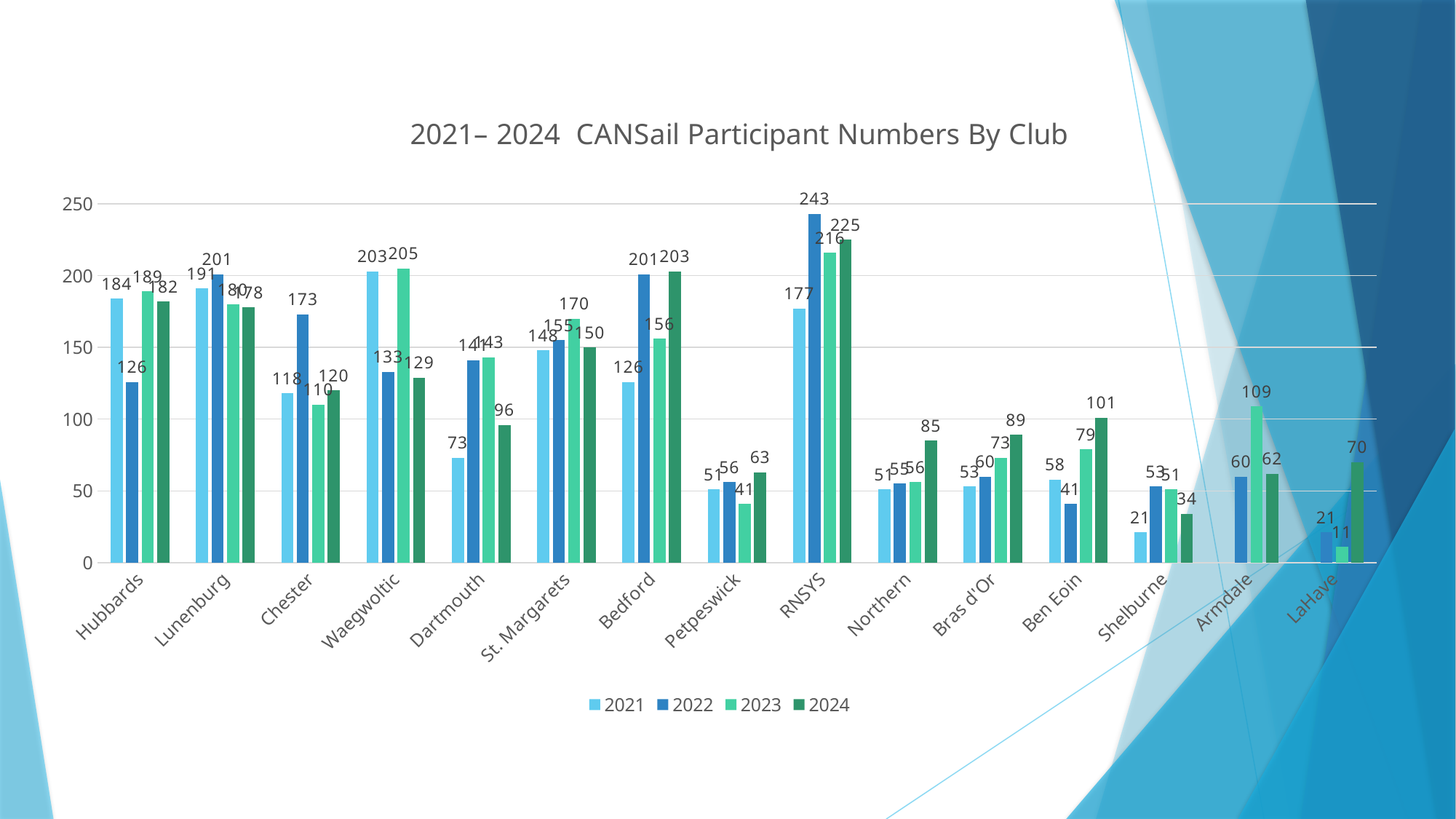
What is the 2023 participant number for Armdale? 109 What is the title of the chart? 2021– 2024 CANSail Participant Numbers By Club What is the difference between Ben Eoin's 2024 and 2021 participant numbers? 43 How many clubs are shown along the x axis? 15 Which club has the lowest 2024 participant number? Shelburne Which club has the highest 2022 participant number? RNSYS What is the 2024 participant number for LaHave? 70 What kind of chart is shown on the slide? bar chart What is the 2022 participant number for RNSYS? 243 Do Bras d'Or's participant numbers rise or fall from 2021 to 2024? rise Which is larger, the 2022 value for Bedford or the 2022 value for Hubbards? Bedford How many series does the legend list? 4